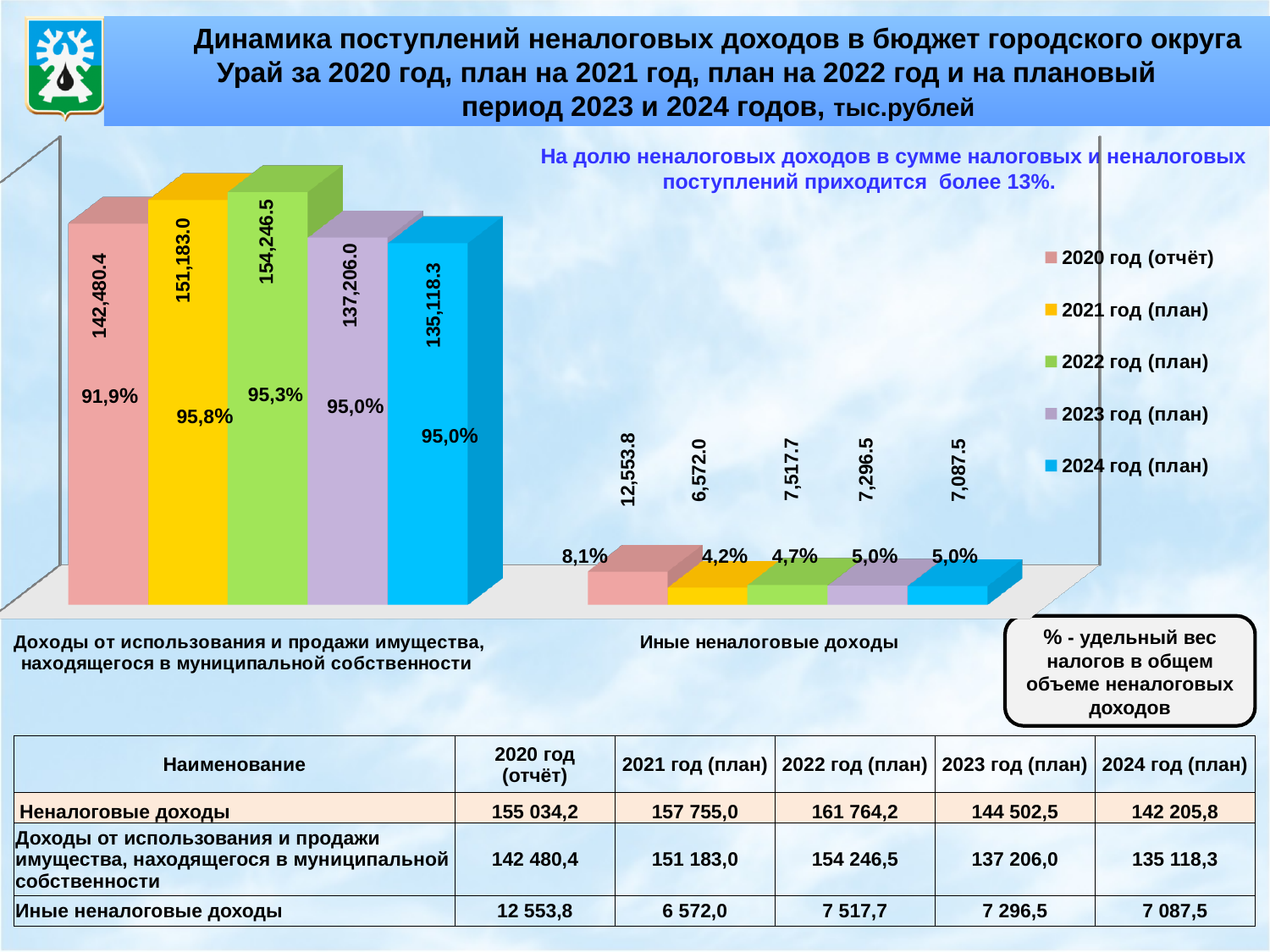
Which is larger in the category 'Иные неналоговые доходы': the value for 2022 год (план) or 2023 год (план)? 2022 год (план) What is the difference between the 2020 год (отчёт) and 2021 год (план) values in the category 'Иные неналоговые доходы'? 5,981.8 What is the value for 2020 год (отчёт) in the category 'Доходы от использования и продажи имущества, находящегося в муниципальной собственности'? 142,480.4 What is the value for 2024 год (план) in the category 'Иные неналоговые доходы'? 7,087.5 Which year has the lowest value in the category 'Иные неналоговые доходы'? 2021 год (план) Which year has the highest value in the category 'Иные неналоговые доходы'? 2020 год (отчёт) What is the difference between the 2022 год (план) and 2020 год (отчёт) values in the category 'Доходы от использования и продажи имущества, находящегося в муниципальной собственности'? 11,766.1 How many categories are shown on the x axis of the chart? 2 How many series does the chart legend list? 5 What is the value for 2022 год (план) in the category 'Доходы от использования и продажи имущества, находящегося в муниципальной собственности'? 154,246.5 What type of chart is shown on the slide? bar chart Which year has the highest value in the category 'Доходы от использования и продажи имущества, находящегося в муниципальной собственности'? 2022 год (план)